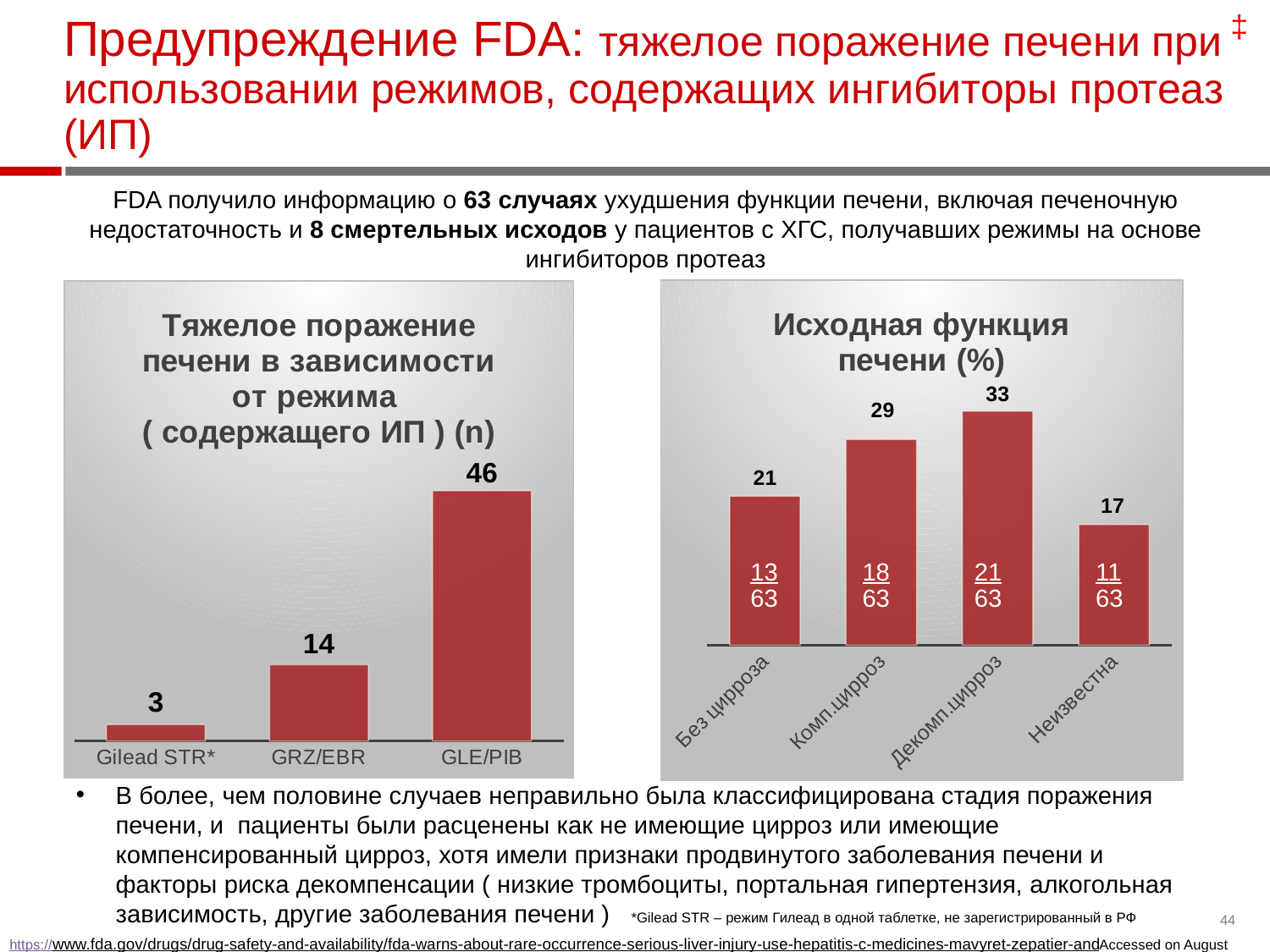
In the right chart (Исходная функция печени (%)), what is the percentage for Декомп.цирроз? 33 In the left chart (Тяжелое поражение печени в зависимости от режима), how many regimens are shown? 3 In the right chart (Исходная функция печени (%)), what is the difference between Комп.цирроз and Без цирроза? 8 In the left chart (Тяжелое поражение печени в зависимости от режима), what is the difference between GLE/PIB and GRZ/EBR? 32 In the left chart (Тяжелое поражение печени в зависимости от режима), what is the value for GLE/PIB? 46 In the right chart (Исходная функция печени (%)), which is larger: Без цирроза or Комп.цирроз? Комп.цирроз In the right chart (Исходная функция печени (%)), what fraction is printed on the Декомп.цирроз bar? 21/63 In the left chart (Тяжелое поражение печени в зависимости от режима), what is the value for Gilead STR*? 3 In the left chart (Тяжелое поражение печени в зависимости от режима), which regimen has the highest value? GLE/PIB In the left chart (Тяжелое поражение печени в зависимости от режима), what type of chart is used? Bar chart In the right chart (Исходная функция печени (%)), which category has the lowest value? Неизвестна In the right chart (Исходная функция печени (%)), what is the percentage for Неизвестна? 17